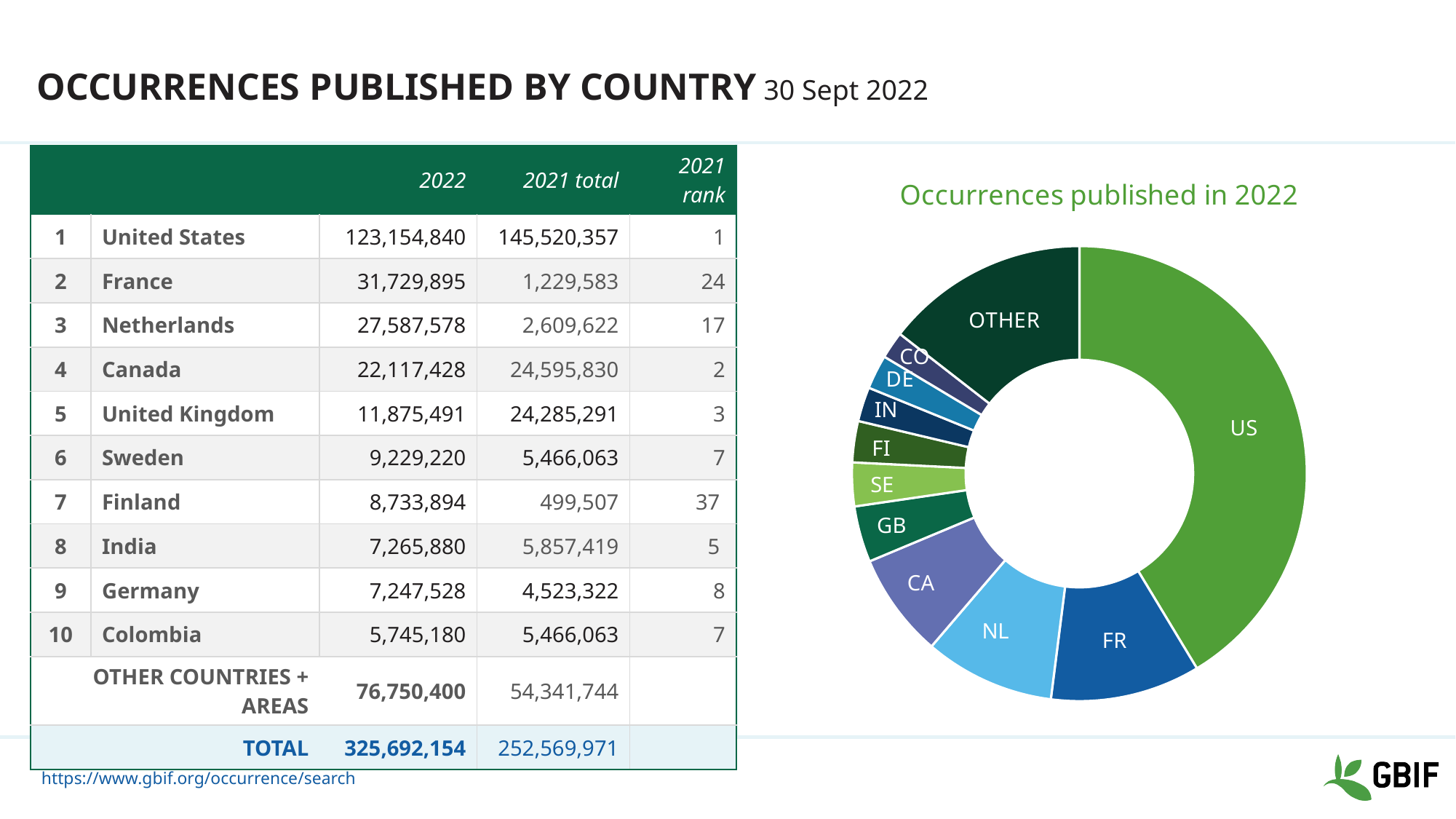
Which slice of the donut chart is the largest? US According to the table, how many occurrences did France publish in 2022 (the FR slice)? 31,729,895 What colour is the US slice in the donut chart? Green What is the title of the chart on the right? Occurrences published in 2022 In the donut chart, which slice is larger, NL or SE? NL According to the table, what is the 2022 value for the OTHER slice (other countries + areas)? 76,750,400 Which country slice of the donut chart is the smallest? CO How many slices does the donut chart have? 11 In the donut chart, which slice is larger, US or OTHER? US In the donut chart, which slice is larger, CA or GB? CA What kind of chart is shown on the right of the slide? Pie chart (donut) According to the table, how many occurrences did the United States publish in 2022 (the US slice)? 123,154,840